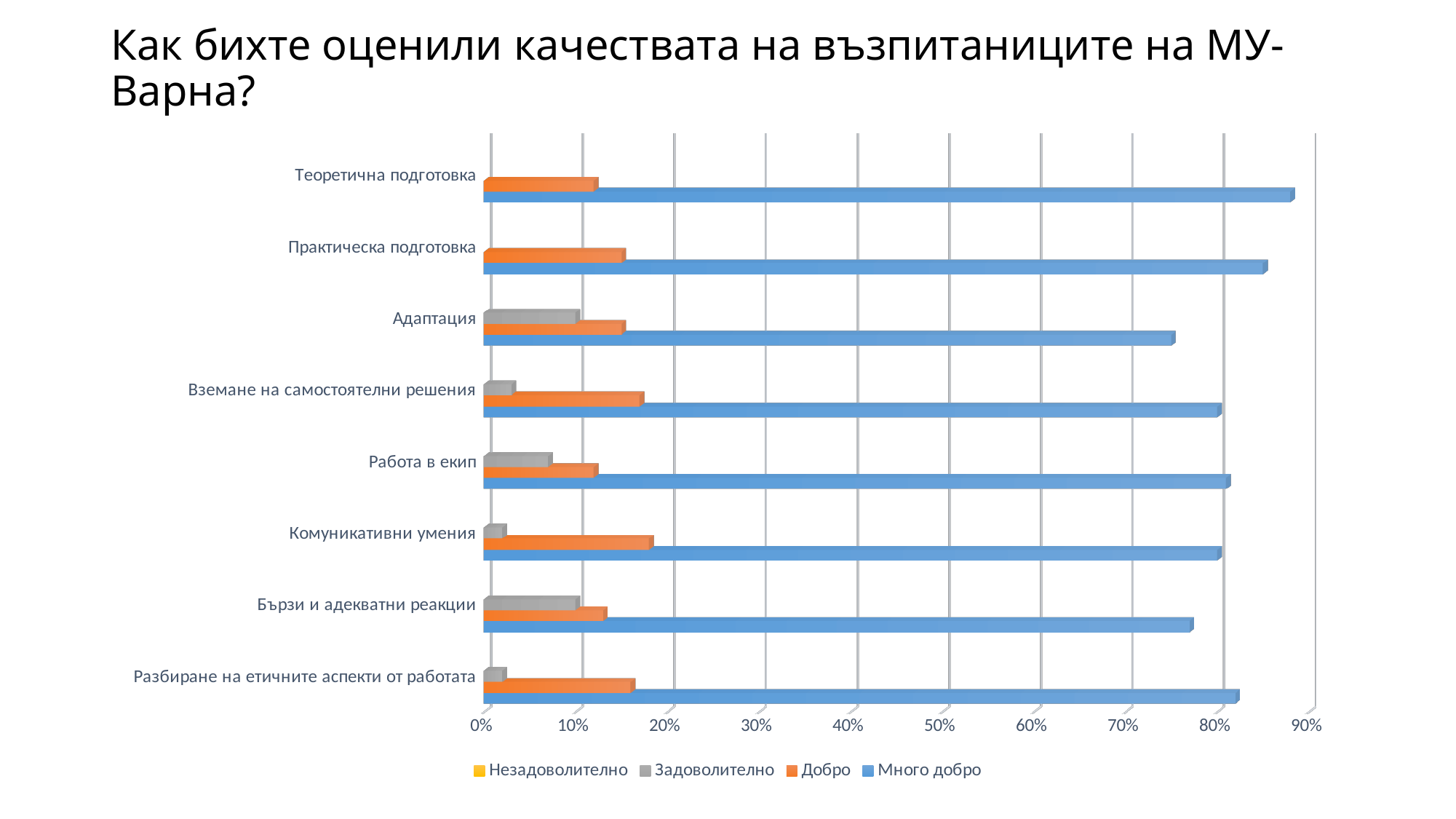
What colour represents the 'Много добро' series in the chart? blue What kind of chart is shown on the slide? bar chart Is the 'Добро' value for 'Комуникативни умения' greater or less than 10%? greater Is the 'Добро' value for 'Вземане на самостоятелни решения' greater or less than 10%? greater How many categories (qualities) are listed on the vertical axis of the chart? 8 Which has the larger 'Много добро' value: 'Теоретична подготовка' or 'Адаптация'? Теоретична подготовка Is the 'Много добро' value for 'Адаптация' greater or less than 80%? less How many series does the chart legend list? 4 Which category has the highest value for the 'Много добро' series? Теоретична подготовка Which has the larger 'Добро' value: 'Комуникативни умения' or 'Теоретична подготовка'? Комуникативни умения